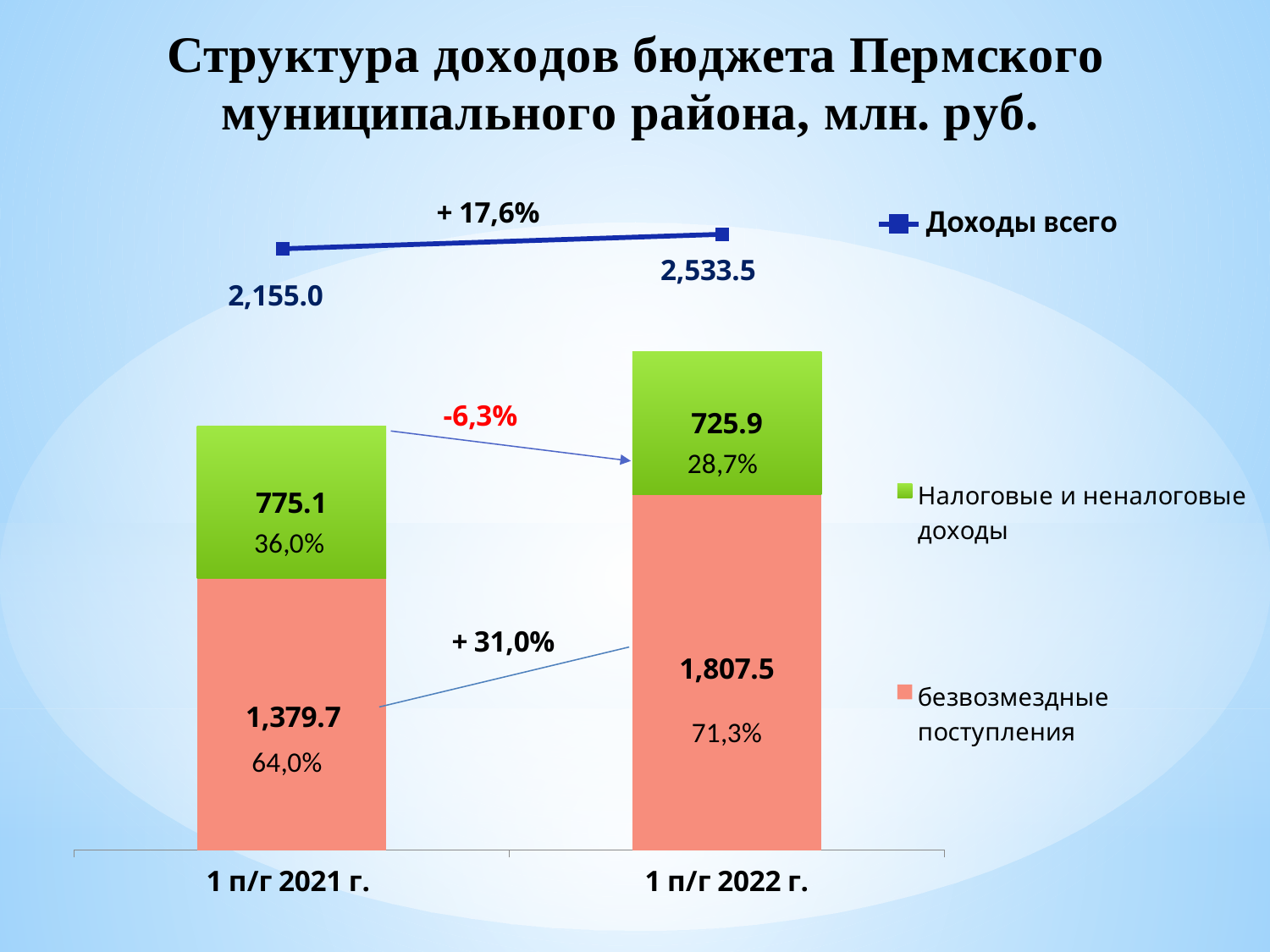
Which period has the highest value of Доходы всего? 1 п/г 2022 г. What share of the total do Налоговые и неналоговые доходы make up in 1 п/г 2022 г., as labelled on the chart? 28,7% What kind of chart is used to show the income structure? Stacked bar chart with a line What is the difference between безвозмездные поступления in 1 п/г 2022 г. and in 1 п/г 2021 г.? 427.8 What percentage change in Доходы всего is labelled on the chart? + 17,6% Which period has the higher value of Налоговые и неналоговые доходы, 1 п/г 2021 г. or 1 п/г 2022 г.? 1 п/г 2021 г. What is the value of безвозмездные поступления for 1 п/г 2022 г.? 1,807.5 How many periods are shown on the x axis? 2 How many series does the legend list? 3 What is the value of Налоговые и неналоговые доходы for 1 п/г 2021 г.? 775.1 What is the value of Доходы всего for 1 п/г 2022 г.? 2,533.5 Does Доходы всего rise or fall from 1 п/г 2021 г. to 1 п/г 2022 г.? Rise